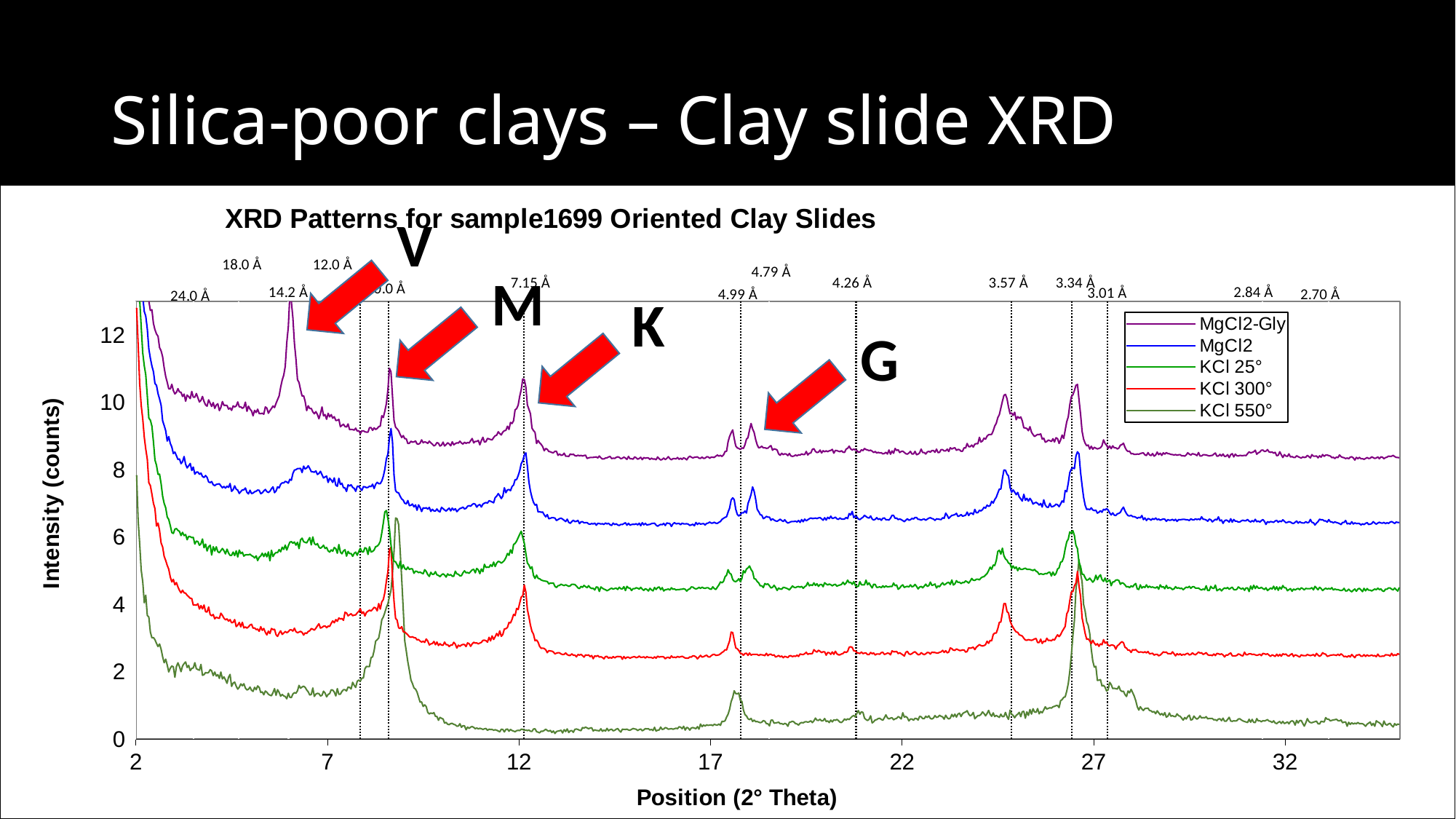
Which series is plotted as the lowest trace across the chart? KCl 550° Is the value for MgCl2-Gly at position 22 greater or less than 6? greater What is the label of the y axis? Intensity (counts) Does the KCl 550° trace rise or fall between position 2 and position 7? Fall What is the title of the chart? XRD Patterns for sample1699 Oriented Clay Slides At position 32, which series has the higher value, MgCl2 or KCl 25°? MgCl2 What kind of chart is shown on the slide? Line chart Is the value for KCl 550° at position 32 greater or less than 2? less Is the value for KCl 300° at position 32 greater or less than 4? less Which series is plotted as the topmost trace across the chart? MgCl2-Gly How many series does the legend list? 5